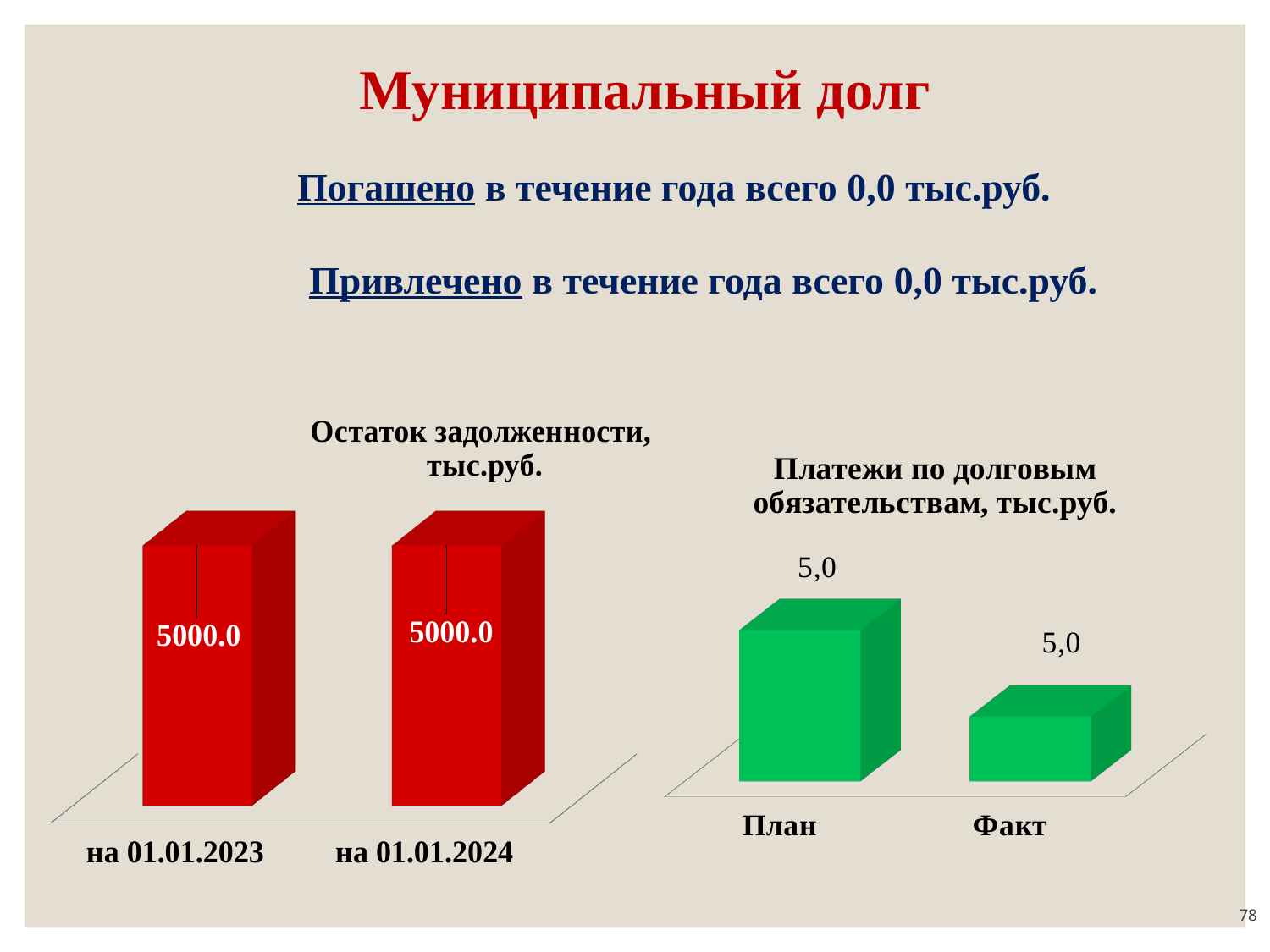
In the chart titled "Платежи по долговым обязательствам, тыс.руб.", how many categories are shown? 2 In the chart titled "Платежи по долговым обязательствам, тыс.руб.", what is the value labelled for Факт? 5,0 What kind of chart is the one titled "Платежи по долговым обязательствам, тыс.руб."? Bar chart In the chart titled "Остаток задолженности, тыс.руб.", what is the value for на 01.01.2023? 5000.0 What colour are the bars in the chart titled "Платежи по долговым обязательствам, тыс.руб."? Green In the chart titled "Остаток задолженности, тыс.руб.", how many categories are shown? 2 In the chart titled "Платежи по долговым обязательствам, тыс.руб.", what is the value labelled for План? 5,0 What kind of chart is the one titled "Остаток задолженности, тыс.руб."? Bar chart In the chart titled "Остаток задолженности, тыс.руб.", what is the difference between the values for на 01.01.2024 and на 01.01.2023? 0.0 In the chart titled "Остаток задолженности, тыс.руб.", do the values rise, fall or stay the same from на 01.01.2023 to на 01.01.2024? Stay the same In the chart titled "Остаток задолженности, тыс.руб.", what is the value for на 01.01.2024? 5000.0 What colour are the bars in the chart titled "Остаток задолженности, тыс.руб."? Red